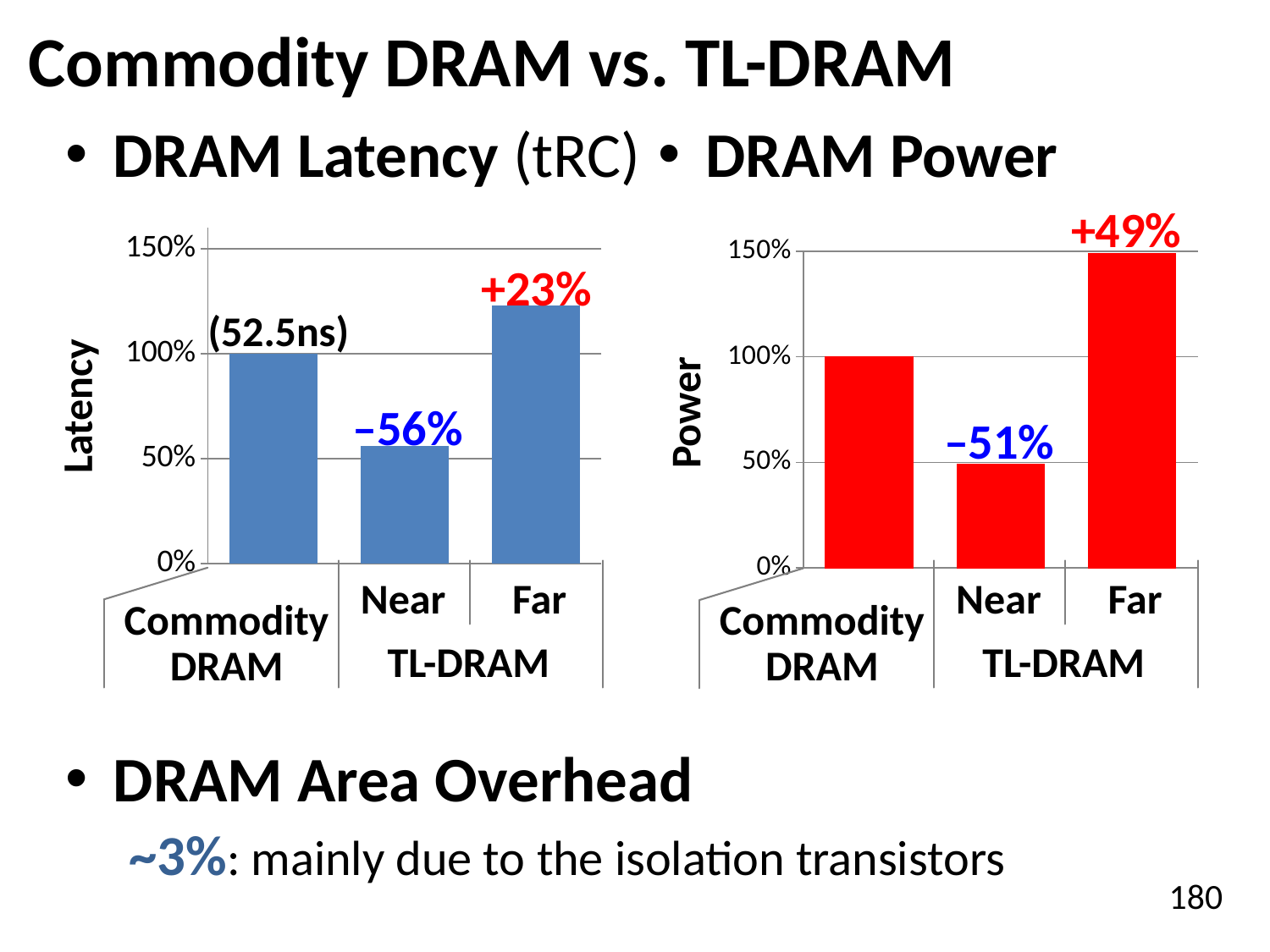
In the DRAM Power chart, what colour are the bars? red In the DRAM Latency chart, which bar is the lowest? Near (TL-DRAM) In the DRAM Latency chart, what is the latency value for Commodity DRAM? 100% In the DRAM Latency chart, what absolute latency is shown in parentheses for Commodity DRAM? 52.5ns In the DRAM Latency chart, what percentage change is labelled above the TL-DRAM Near bar? –56% In the DRAM Power chart, what percentage change is labelled above the TL-DRAM Near bar? –51% In the DRAM Power chart, what percentage change is labelled above the TL-DRAM Far bar? +49% In the DRAM Latency chart, what kind of chart is used? bar chart In the DRAM Power chart, which bar is the highest? Far (TL-DRAM) In the DRAM Latency chart, is the value for TL-DRAM Near greater or less than 50%? greater In the DRAM Latency chart, how many bars are plotted? 3 In the DRAM Latency chart, what percentage change is labelled above the TL-DRAM Far bar? +23%